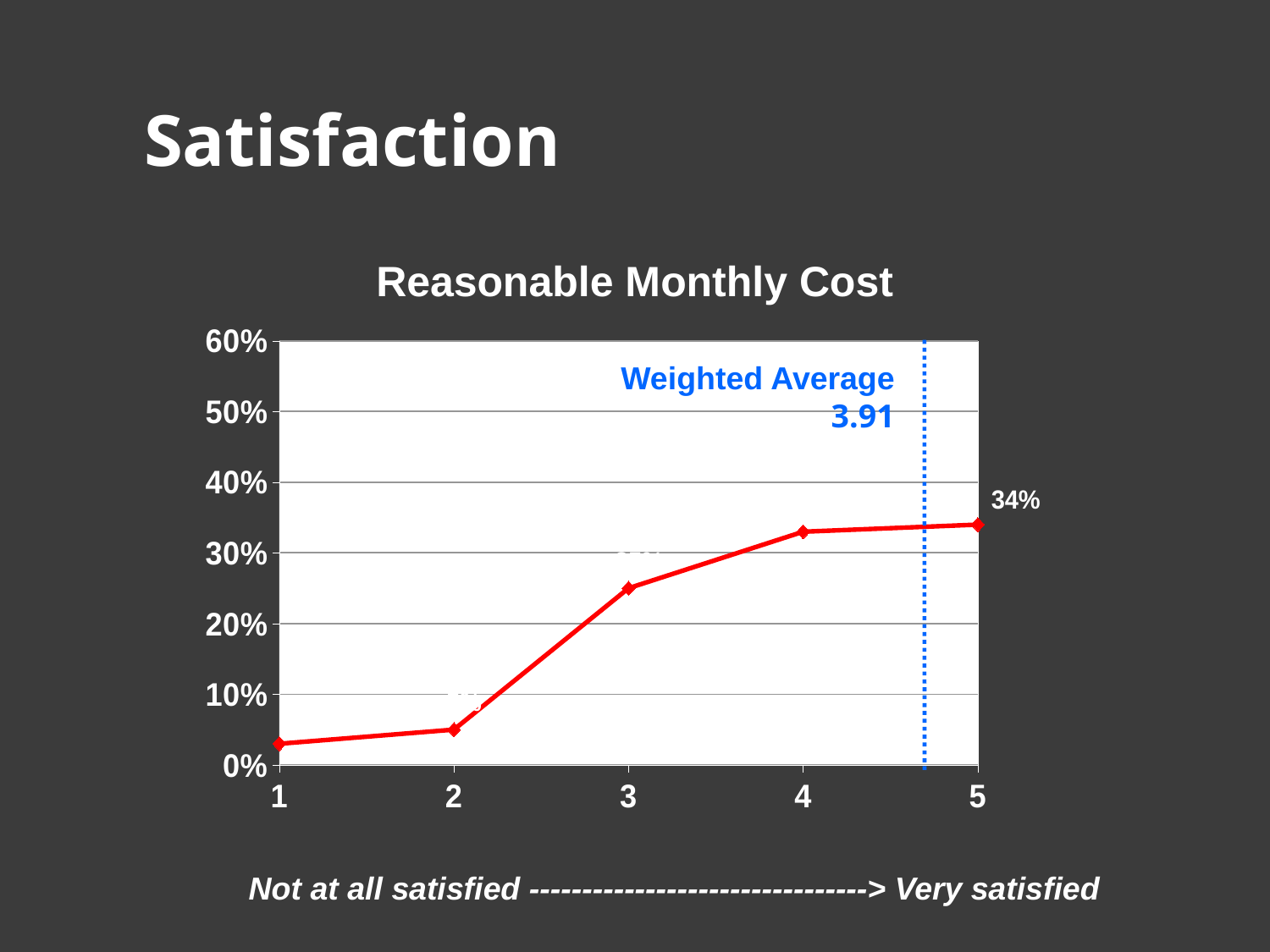
How many data points are plotted in the Reasonable Monthly Cost chart? 5 What is the value for category 5 in the Reasonable Monthly Cost chart? 34% Is the value for category 3 greater or less than 20%? greater Do the values rise or fall from category 1 to category 5? rise Which has a larger value, category 1 or category 3? 3 Which category has the lowest value in the Reasonable Monthly Cost chart? 1 What kind of chart is shown on the slide? line chart Is the value for category 2 greater or less than 10%? less What weighted average is printed on the Reasonable Monthly Cost chart? 3.91 Which has a larger value, category 3 or category 4? 4 Which category has the highest value in the Reasonable Monthly Cost chart? 5 Is the value for category 4 greater or less than 30%? greater